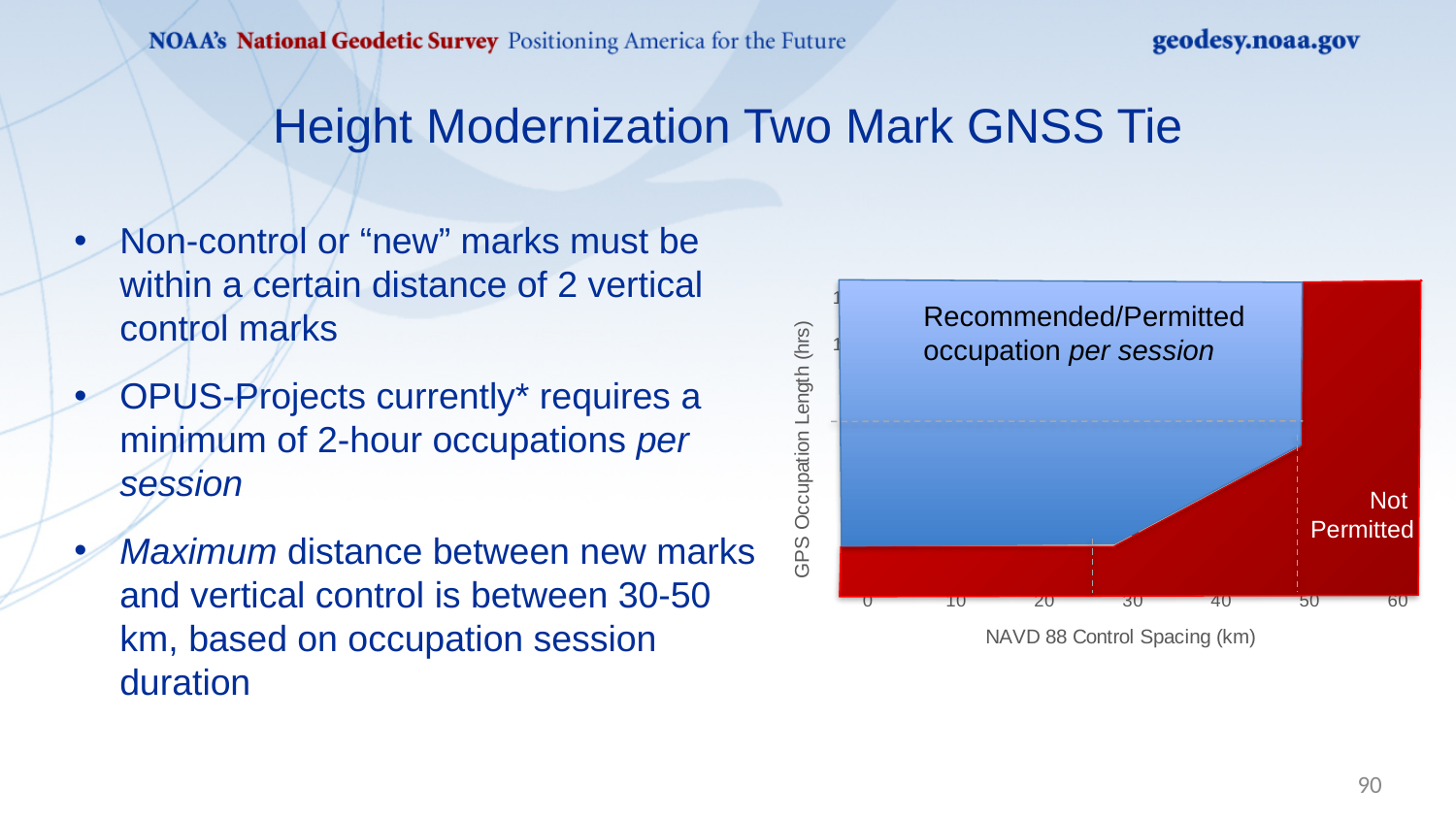
What label is shown in the red region on the right side of the chart? Not Permitted What kind of chart is shown on the slide? area chart What is the title of the x axis of the chart? NAVD 88 Control Spacing (km) What label is shown in the blue region of the chart? Recommended/Permitted occupation per session Does the boundary of the blue permitted region rise or fall as control spacing increases from 30 km to 50 km? rise What is the title of the y axis of the chart? GPS Occupation Length (hrs) How many tick labels are shown on the x axis of the chart? 7 What is the highest value labelled on the x axis of the chart? 60